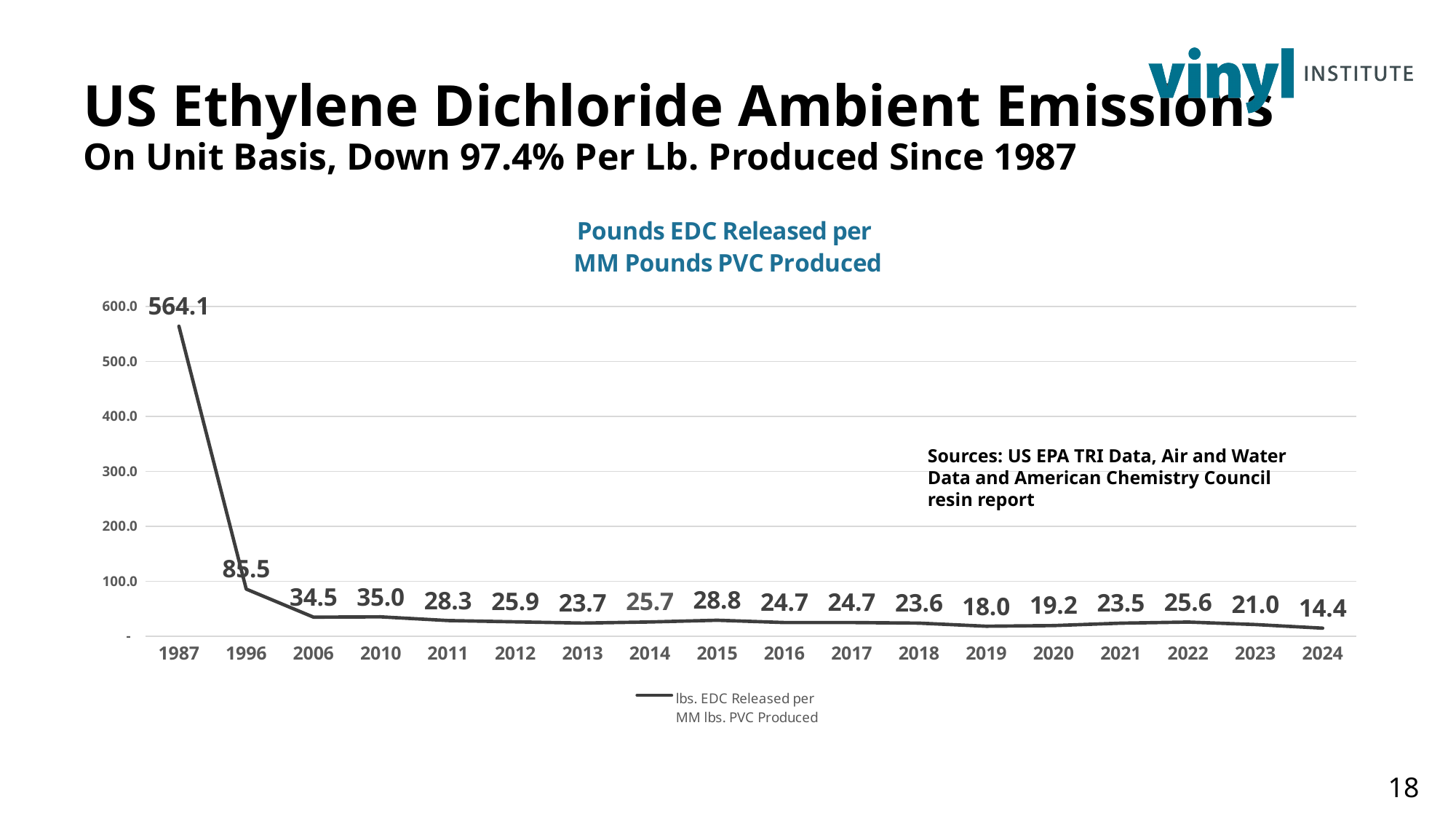
How many years are plotted on the x axis? 18 How many series does the legend list? 1 What is the value for 2019? 18.0 Which year has the highest value? 1987 Which is larger, the value for 2015 or the value for 2016? 2015 Is the value for 1996 greater or less than 100.0? less Do the values generally rise or fall from 1987 to 2024? fall What kind of chart is shown? line chart Which year has the lowest value? 2024 What is the difference between the values for 1996 and 2006? 51.0 What is the value for 2024? 14.4 What is the value for 1987? 564.1